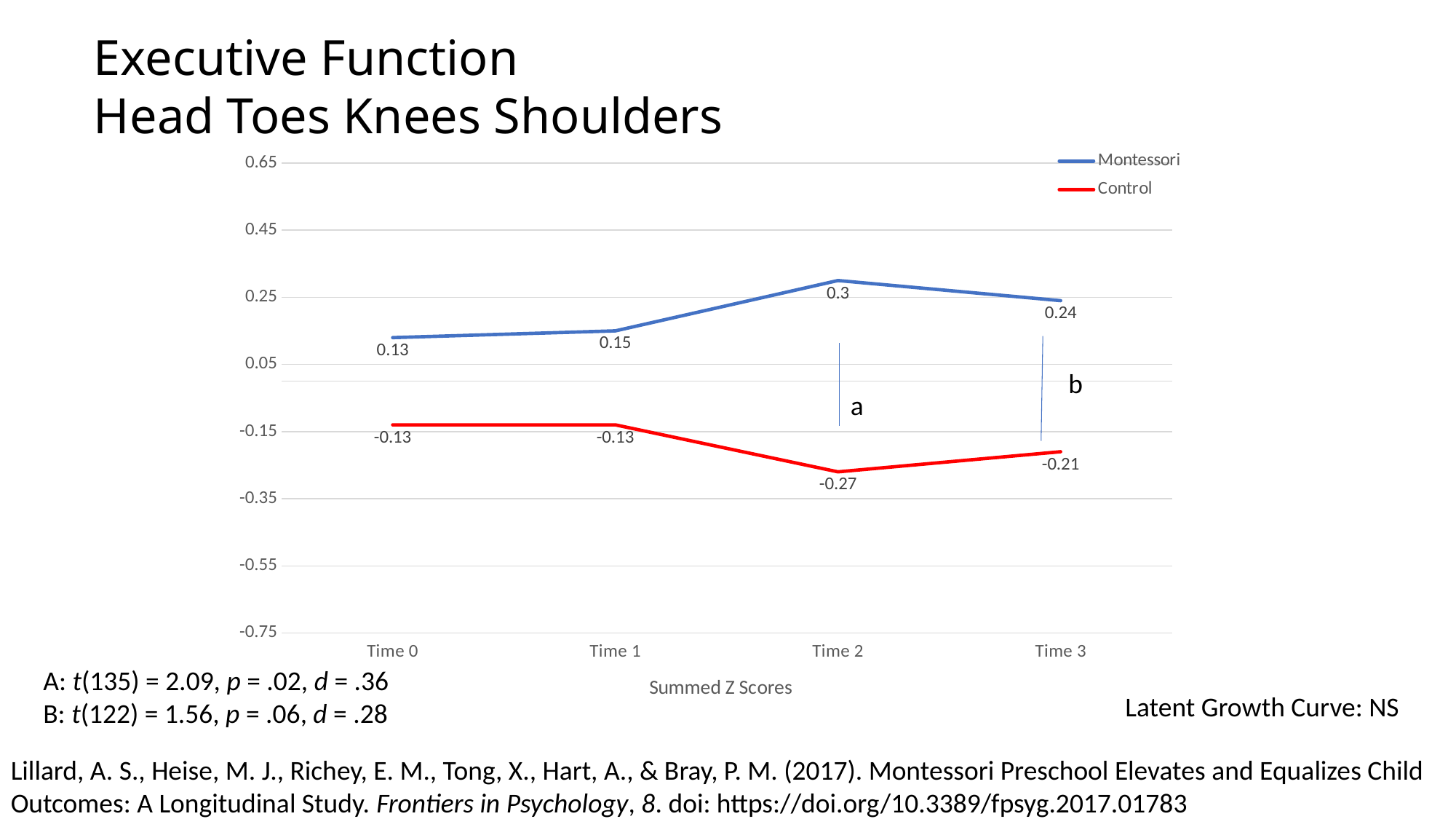
Does the Montessori series rise or fall from Time 0 to Time 2? Rise Which series has the larger value at Time 3, Montessori or Control? Montessori What is the Montessori value at Time 2? 0.3 What is the Montessori value at Time 0? 0.13 How many time points are plotted on the x axis? 4 What colour is the Control line in the chart? Red At which time point is the Control series lowest? Time 2 How many series does the legend list? 2 What kind of chart is shown on the slide? Line chart What is the Control value at Time 3? -0.21 At which time point is the Montessori series highest? Time 2 What is the difference between the Montessori and Control values at Time 2? 0.57